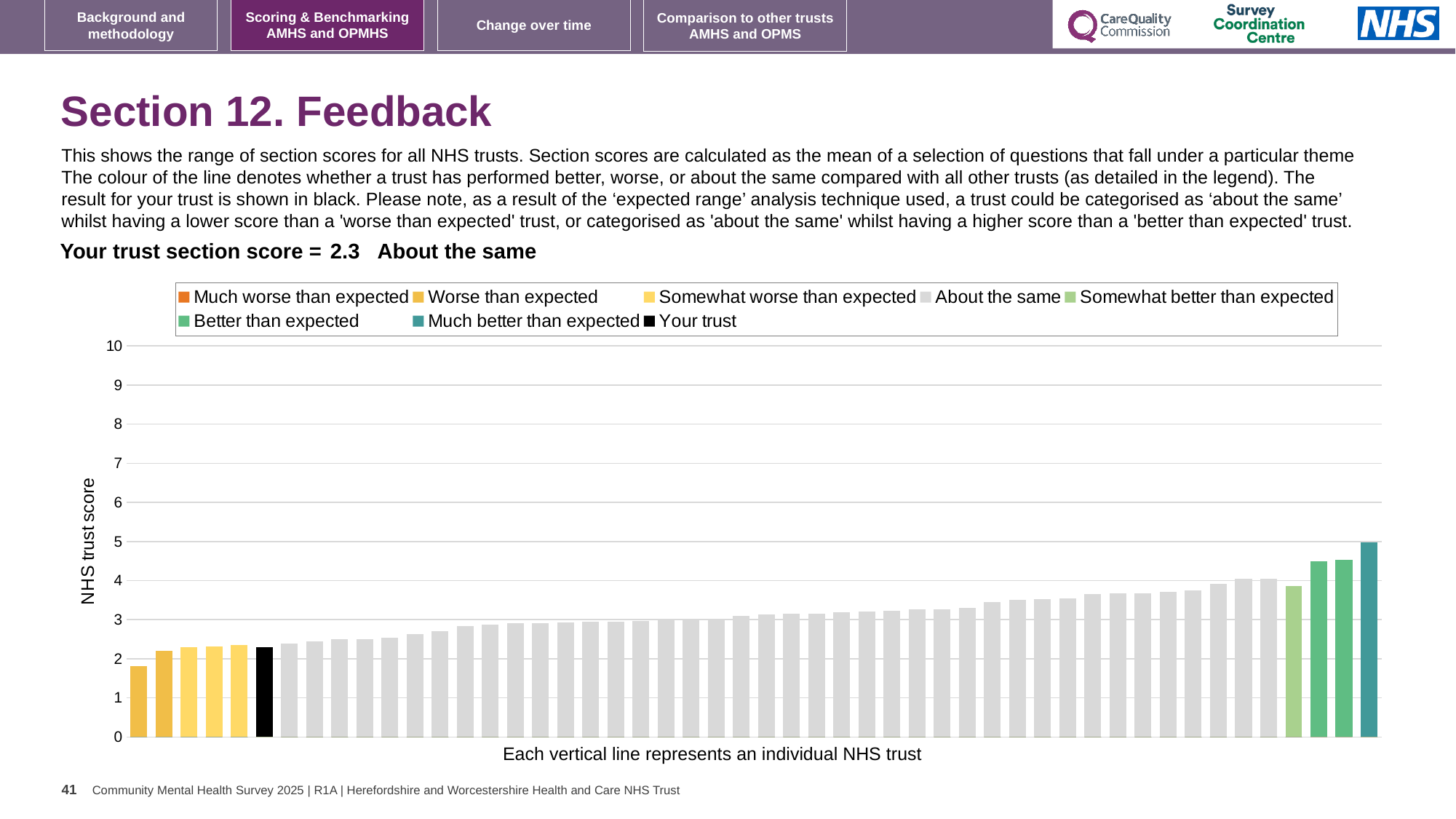
Is the value of the tallest bar greater or less than 4? greater Is the value of the shortest bar greater or less than 2? less What is the title of the y axis? NHS trust score Do the bar values rise or fall from left to right along the x axis? rise How many bars are coloured as 'Better than expected'? 2 What is the section score for your trust shown on the slide? 2.3 What colour is the bar representing your trust? black What kind of chart is shown on the slide? bar chart Is the value of the black 'Your trust' bar greater or less than 3? less How many bars are coloured as 'Much better than expected'? 1 How many entries does the chart legend list? 8 Which category is your trust placed in for this section? About the same